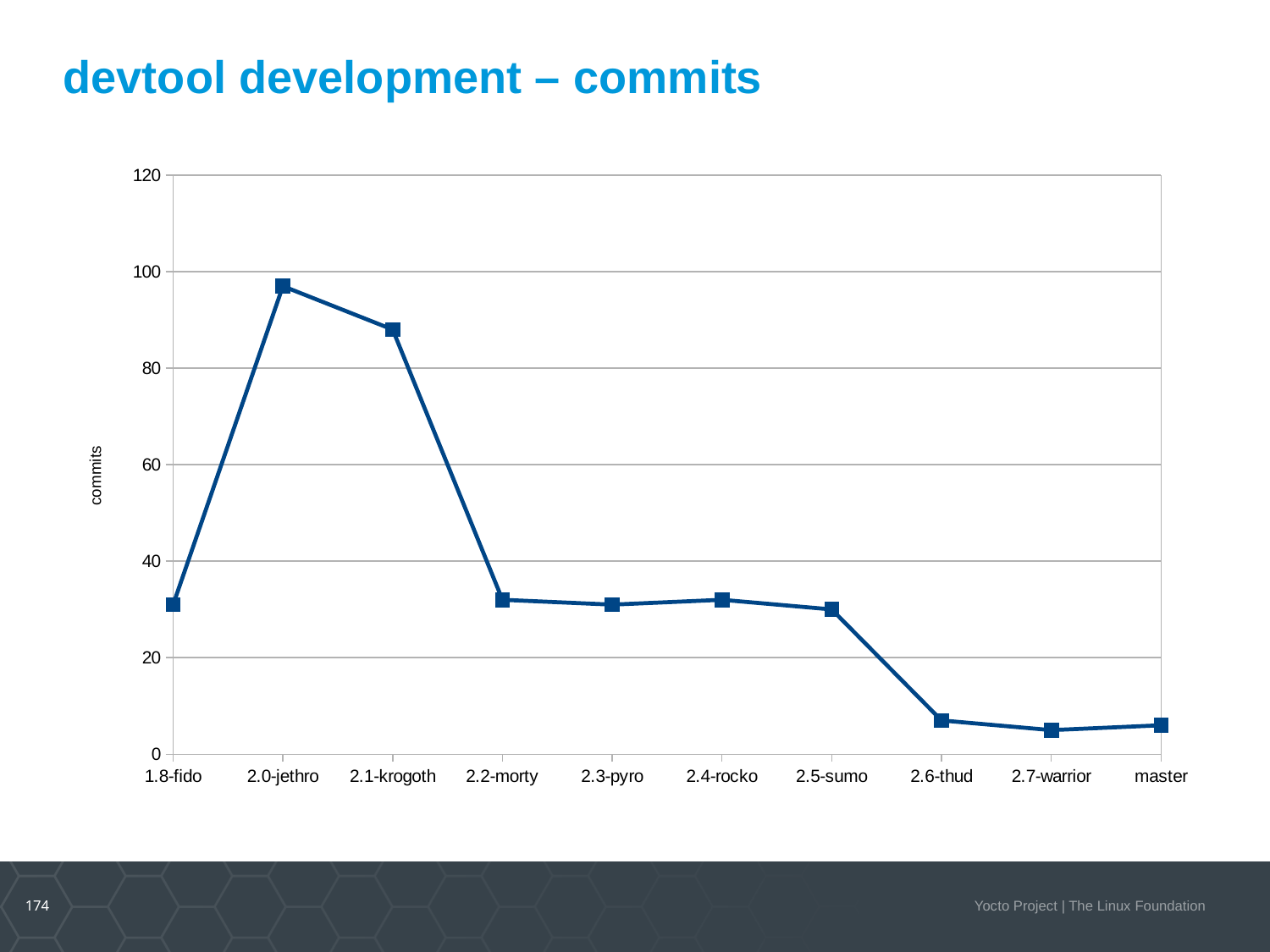
What is the label on the y axis? commits What kind of chart is shown on the slide? line chart How many releases are plotted along the x axis? 10 Is the value for 1.8-fido greater or less than 40? less Which release has the highest number of commits? 2.0-jethro Which has more commits, 2.2-morty or 2.7-warrior? 2.2-morty Is the value for 2.6-thud greater or less than 20? less Do the values rise or fall from 2.5-sumo to 2.6-thud? fall Is the value for 2.4-rocko greater or less than 20? greater Which has more commits, 2.0-jethro or 2.1-krogoth? 2.0-jethro